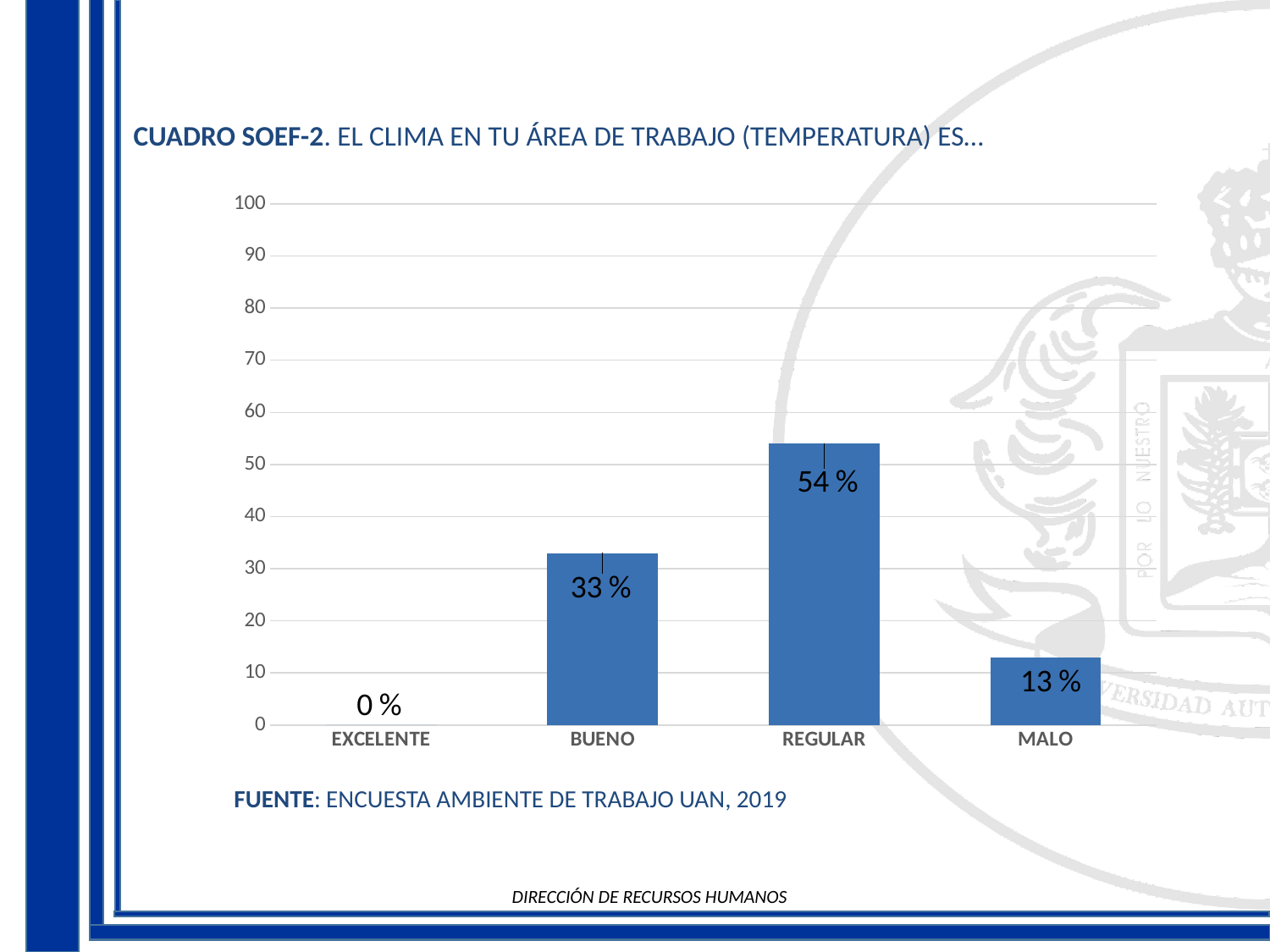
What is the value for EXCELENTE? 0 % What is the value for MALO? 13 % What is the value for BUENO? 33 % Which category has the lowest value? EXCELENTE Which category has the highest value? REGULAR Which is larger, the value for BUENO or the value for MALO? BUENO What is the difference between the values for REGULAR and BUENO? 21 % Is the value for REGULAR greater or less than 50? greater What is the value for REGULAR? 54 % What kind of chart is shown on the slide? bar chart How many categories are shown on the x axis? 4 What source is cited below the chart? ENCUESTA AMBIENTE DE TRABAJO UAN, 2019